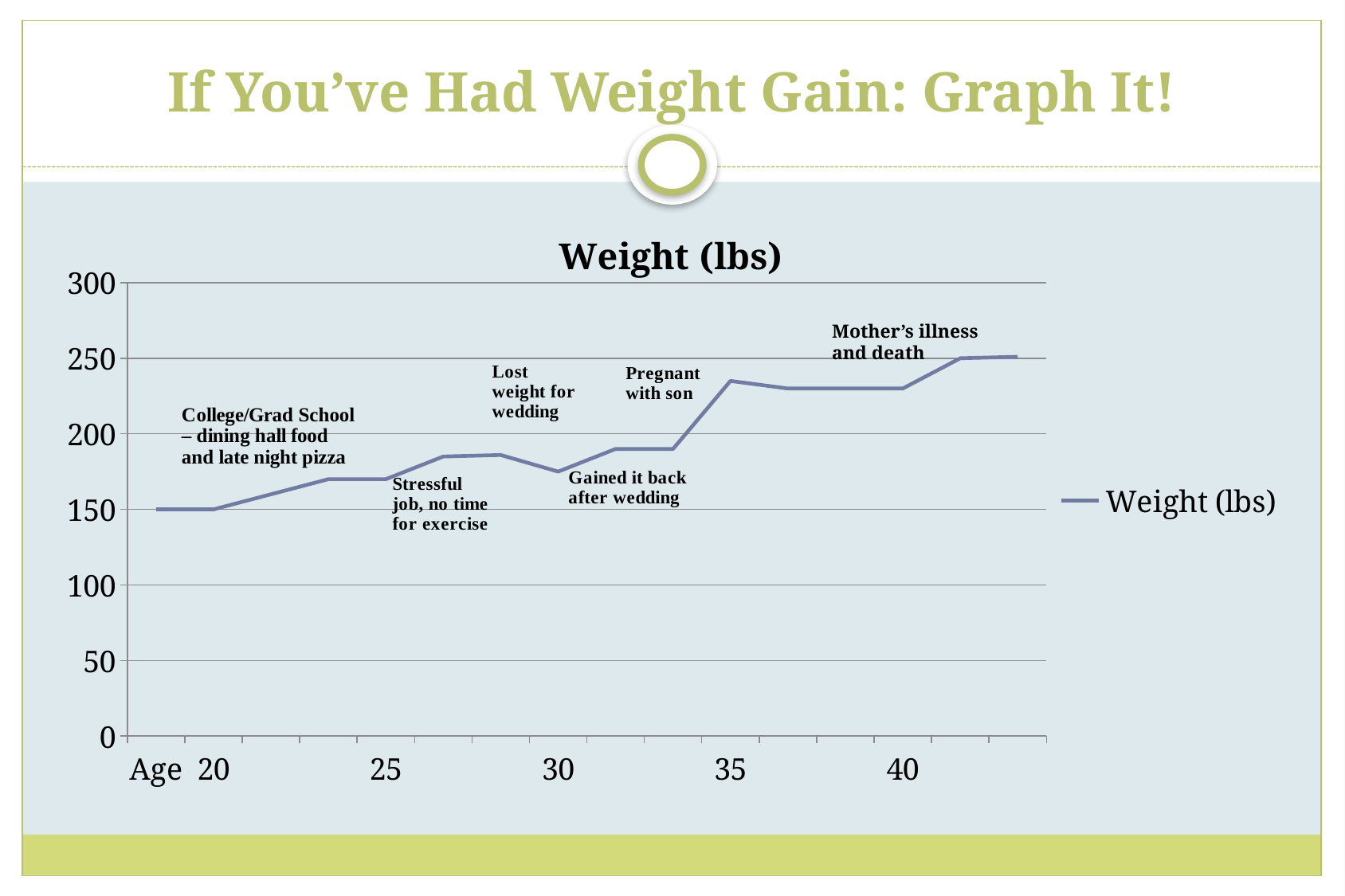
Among the labeled ages on the x axis, at which age is the weight lowest? 20 Does the weight generally rise or fall as age increases? rise What kind of chart is shown on the slide? line chart Is the weight at age 40 greater or less than 250? less How many series does the legend list? 1 Is the weight at age 25 greater or less than 150? greater What is the weight at age 20? 150 Is the weight at age 35 greater or less than 200? greater What is the title of the chart? Weight (lbs) Which is larger, the weight at age 25 or the weight at age 35? age 35 How many age labels are shown on the x axis? 5